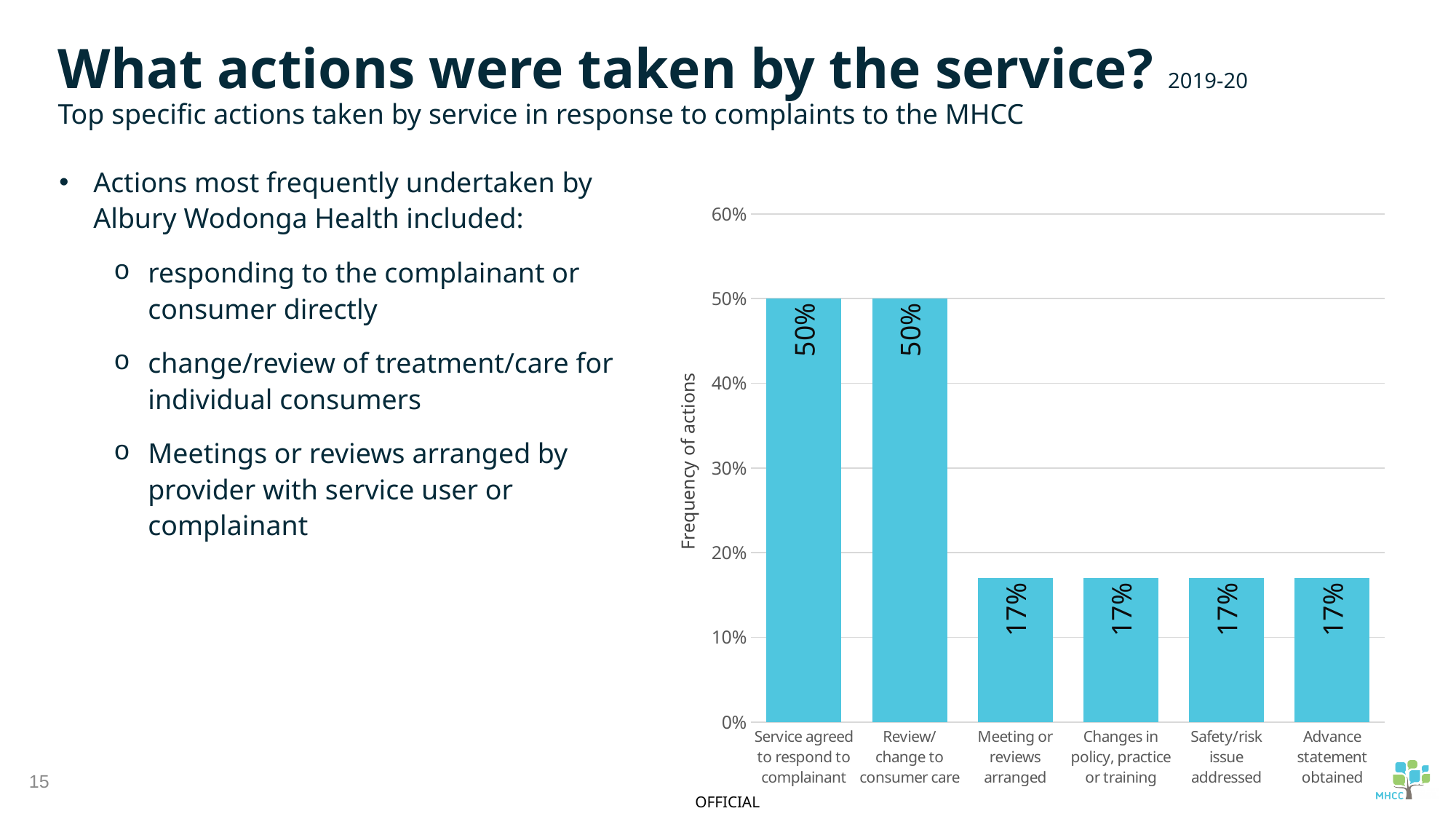
Do the values rise or fall from left to right along the x axis? fall Is the value for 'Safety/risk issue addressed' greater or less than 20%? less Is the value for 'Service agreed to respond to complainant' greater or less than 40%? greater What is the value for 'Changes in policy, practice or training'? 17% How many categories are shown on the x axis of the chart? 6 What is the difference between the value for 'Review/change to consumer care' and the value for 'Meeting or reviews arranged'? 33% What is the highest value shown on the vertical axis of the chart? 60% Which is larger, the value for 'Review/change to consumer care' or the value for 'Safety/risk issue addressed'? Review/change to consumer care What is the value for 'Service agreed to respond to complainant'? 50% What kind of chart is shown on the slide? bar chart What is the value for 'Advance statement obtained'? 17% What is the label of the vertical axis of the chart? Frequency of actions